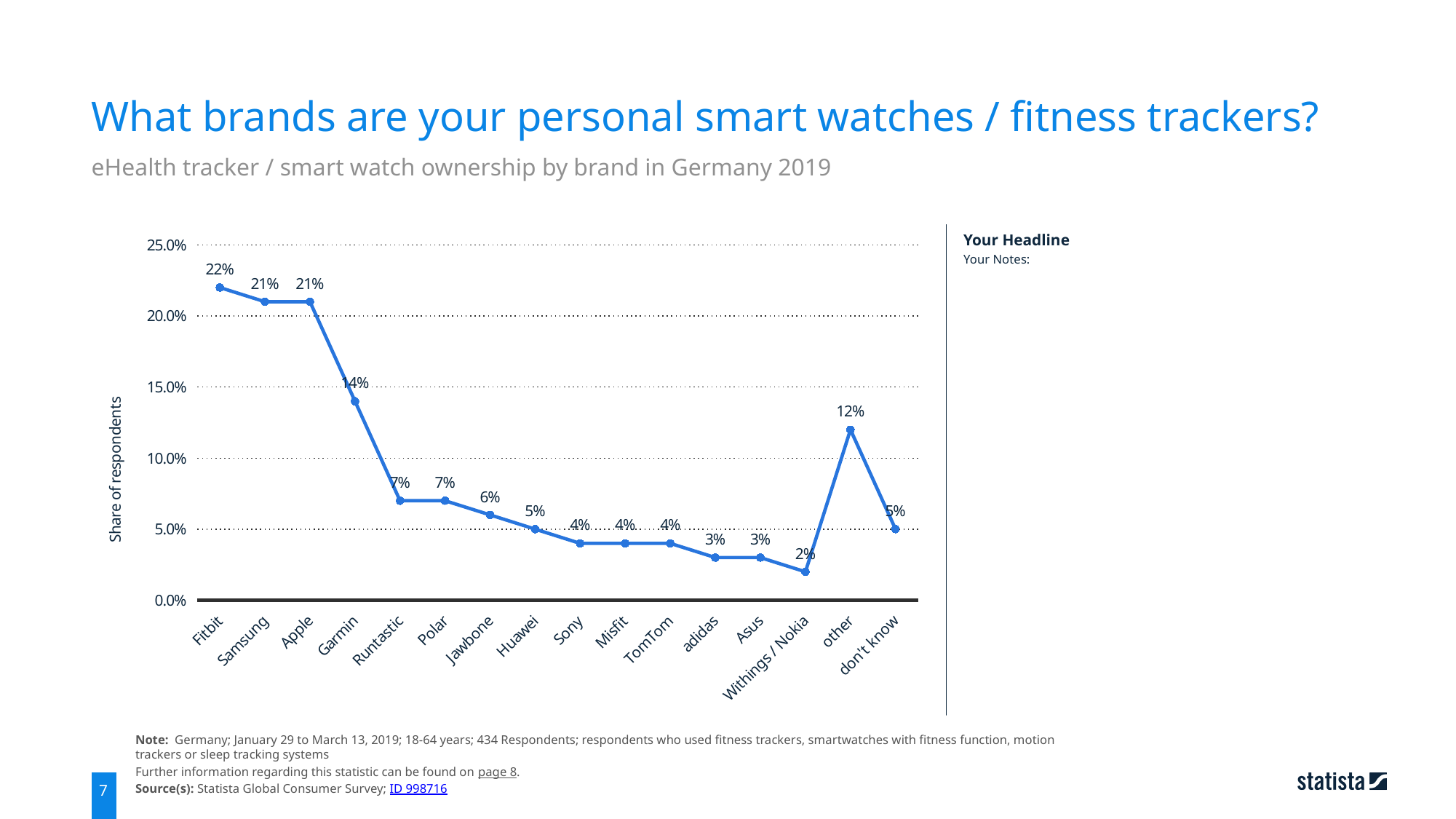
What is the share of respondents for Withings / Nokia? 2% How many categories are plotted on the x axis? 16 What is the share of respondents for 'other'? 12% Which category has the lowest share of respondents? Withings / Nokia Which brand has the highest share of respondents? Fitbit Which has a larger share of respondents, Huawei or Jawbone? Jawbone What is the share of respondents for Fitbit? 22% What is the share of respondents for Garmin? 14% What kind of chart is shown on the slide? Line chart What is the difference between the share for Fitbit and the share for Garmin? 8% Is the value for Apple greater or less than 20.0%? greater What is the label of the y axis? Share of respondents